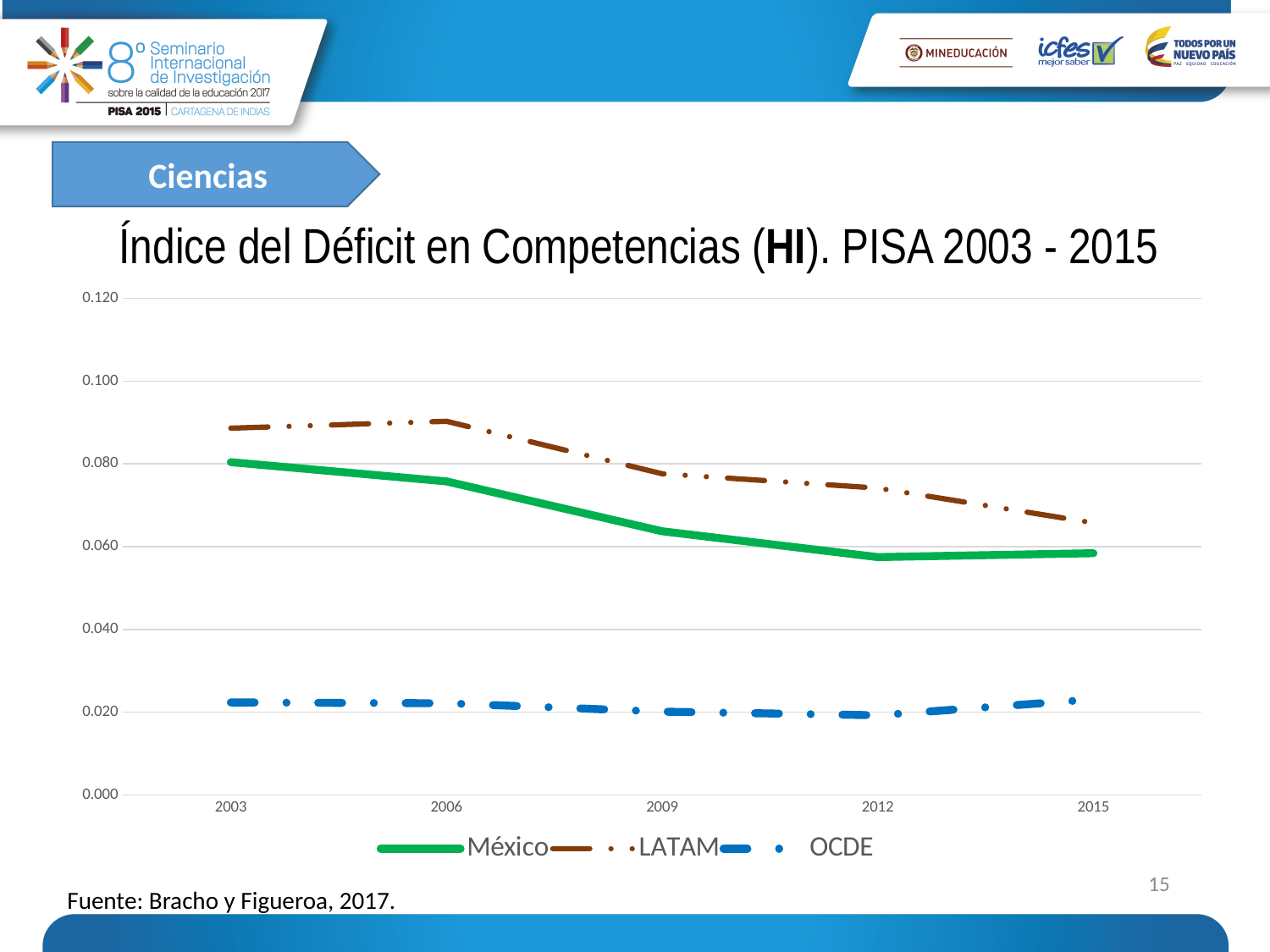
Is the value for México in 2012 greater or less than 0.060? less Which is larger for México: the value in 2003 or the value in 2015? 2003 Which series is drawn with the solid green line? México Does the México line rise or fall from 2003 to 2012? fall Is the value for LATAM in 2003 greater or less than 0.080? greater How many years are plotted along the x axis? 5 What kind of chart is shown on the slide? line chart Does the LATAM line rise or fall from 2003 to 2015? fall Which series has the lowest values across all years? OCDE How many series does the legend list? 3 Which series has the highest value in 2003? LATAM Is the value for México in 2006 greater or less than 0.080? less